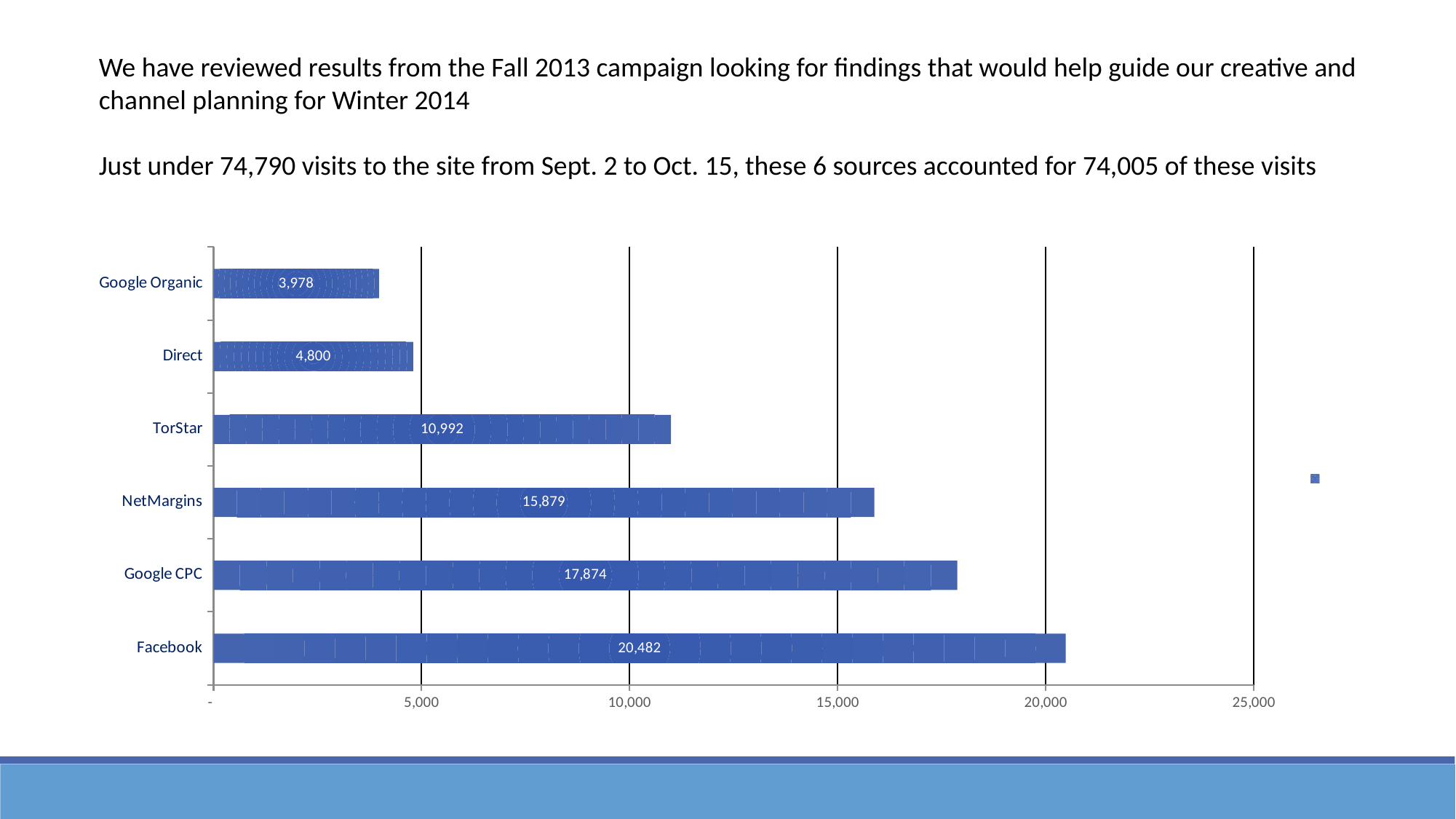
Which is larger, the value for Google CPC or the value for NetMargins? Google CPC What is the value shown for TorStar? 10,992 Is the value for TorStar greater or less than 10,000? greater Which source has the lowest number of visits? Google Organic What is the difference between the Facebook and Google CPC values? 2,608 What is the value shown for NetMargins? 15,879 Which source has the highest number of visits? Facebook How many sources are shown in the chart? 6 What kind of chart is shown on the slide? Bar chart What is the difference between the Direct and Google Organic values? 822 What is the value shown for Google Organic? 3,978 How many visits did Facebook account for? 20,482